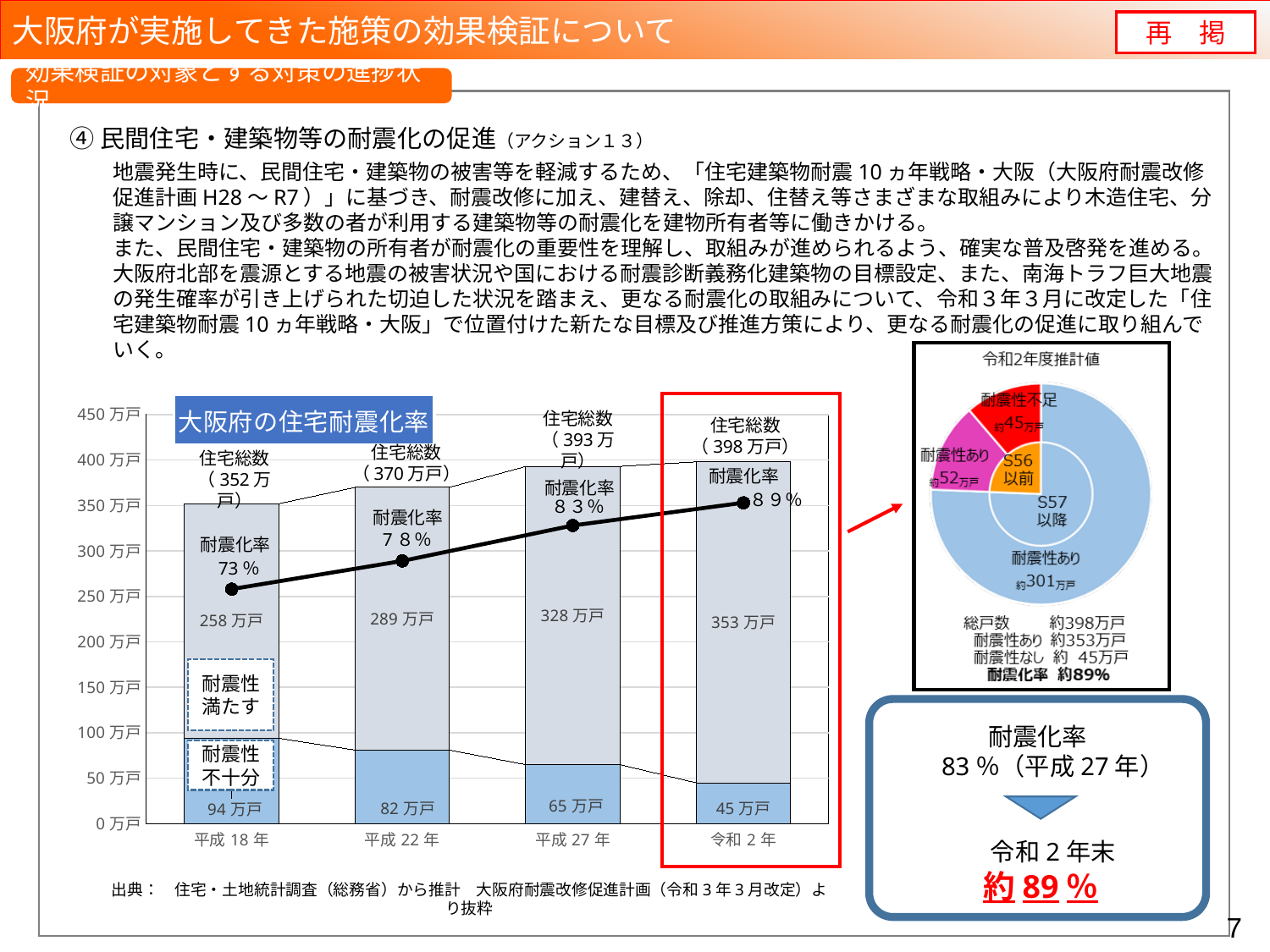
In the pie chart titled 令和2年度推計値, what is the value shown for 耐震性不足? 約45万戸 In the chart titled 大阪府の住宅耐震化率, what is the value of 耐震性不十分 for 令和2年? 45万戸 In the chart titled 大阪府の住宅耐震化率, how many years are shown on the x axis? 4 In the chart titled 大阪府の住宅耐震化率, does the 耐震化率 line rise or fall from 平成18年 to 令和2年? Rise In the chart titled 大阪府の住宅耐震化率, what is the 耐震化率 shown for 平成22年? 78% What kind of chart is the chart titled 大阪府の住宅耐震化率? Stacked bar chart with a line In the chart titled 大阪府の住宅耐震化率, what is the 住宅総数 shown for 平成27年? 393万戸 In the chart titled 大阪府の住宅耐震化率, what is the difference between the 耐震性満たす values for 令和2年 and 平成18年? 95万戸 In the chart titled 大阪府の住宅耐震化率, what is the value of 耐震性満たす for 平成18年? 258万戸 In the chart titled 大阪府の住宅耐震化率, which year has the highest 耐震性満たす value? 令和2年 In the chart titled 大阪府の住宅耐震化率, which year has the lowest 耐震性不十分 value? 令和2年 In the chart titled 大阪府の住宅耐震化率, which is larger: the 耐震性不十分 value for 平成22年 or for 平成27年? 平成22年